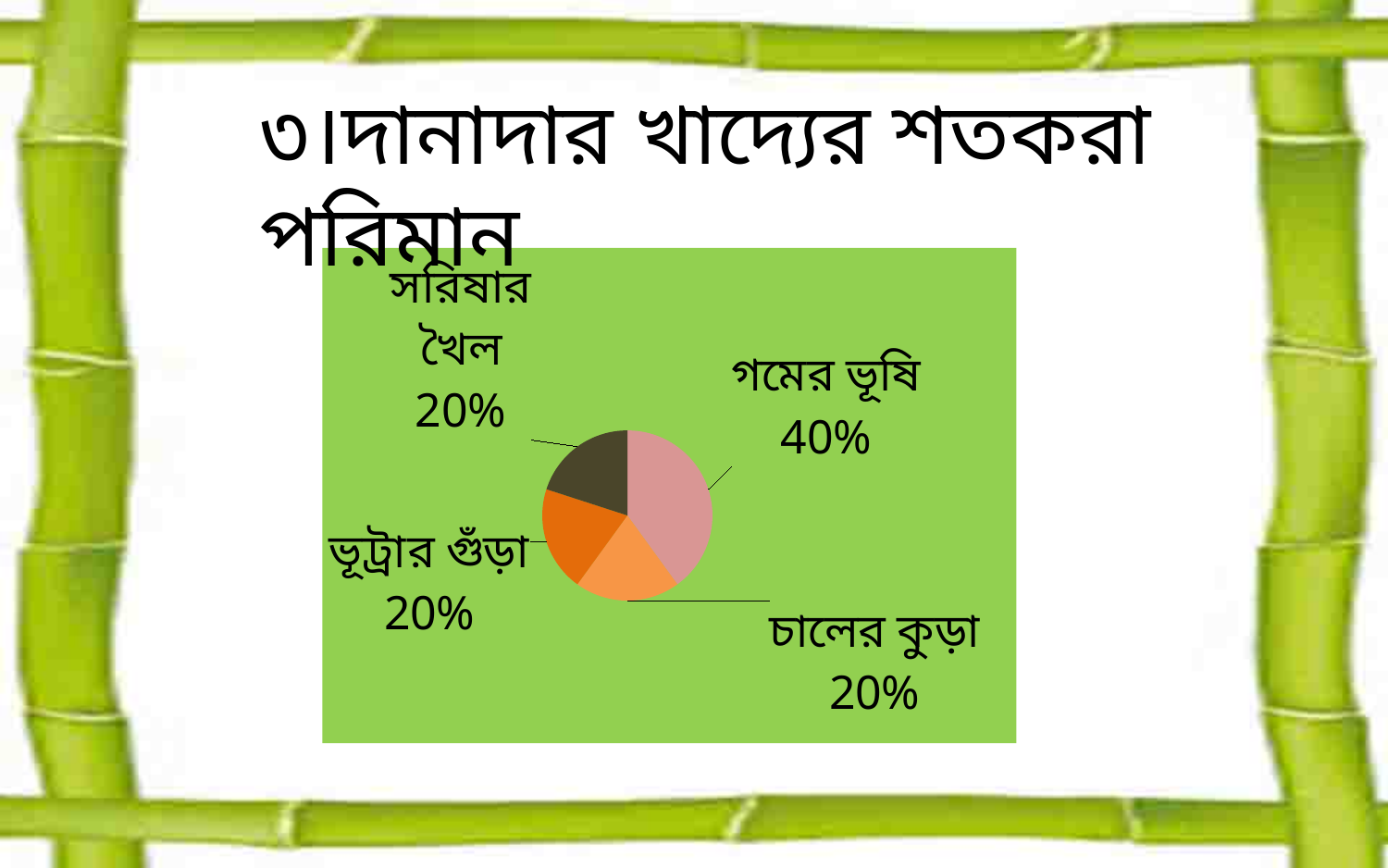
What kind of chart is shown on the slide? pie chart How many slices does the pie chart have? 4 What share of the pie does গমের ভূষি represent? 40% What percentage is shown for চালের কুড়া? 20% What percentage is shown for ভূট্টার গুঁড়া? 20% What is the difference between the share of গমের ভূষি and the share of চালের কুড়া? 20% How many categories share the same value of 20%? 3 What percentage is shown for সরিষার খৈল? 20% What is the title of the slide above the chart? ৩।দানাদার খাদ্যের শতকরা পরিমান Which category has the largest slice of the pie? গমের ভূষি What percentage is shown for গমের ভূষি? 40% Which is larger, the share of গমের ভূষি or the share of সরিষার খৈল? গমের ভূষি